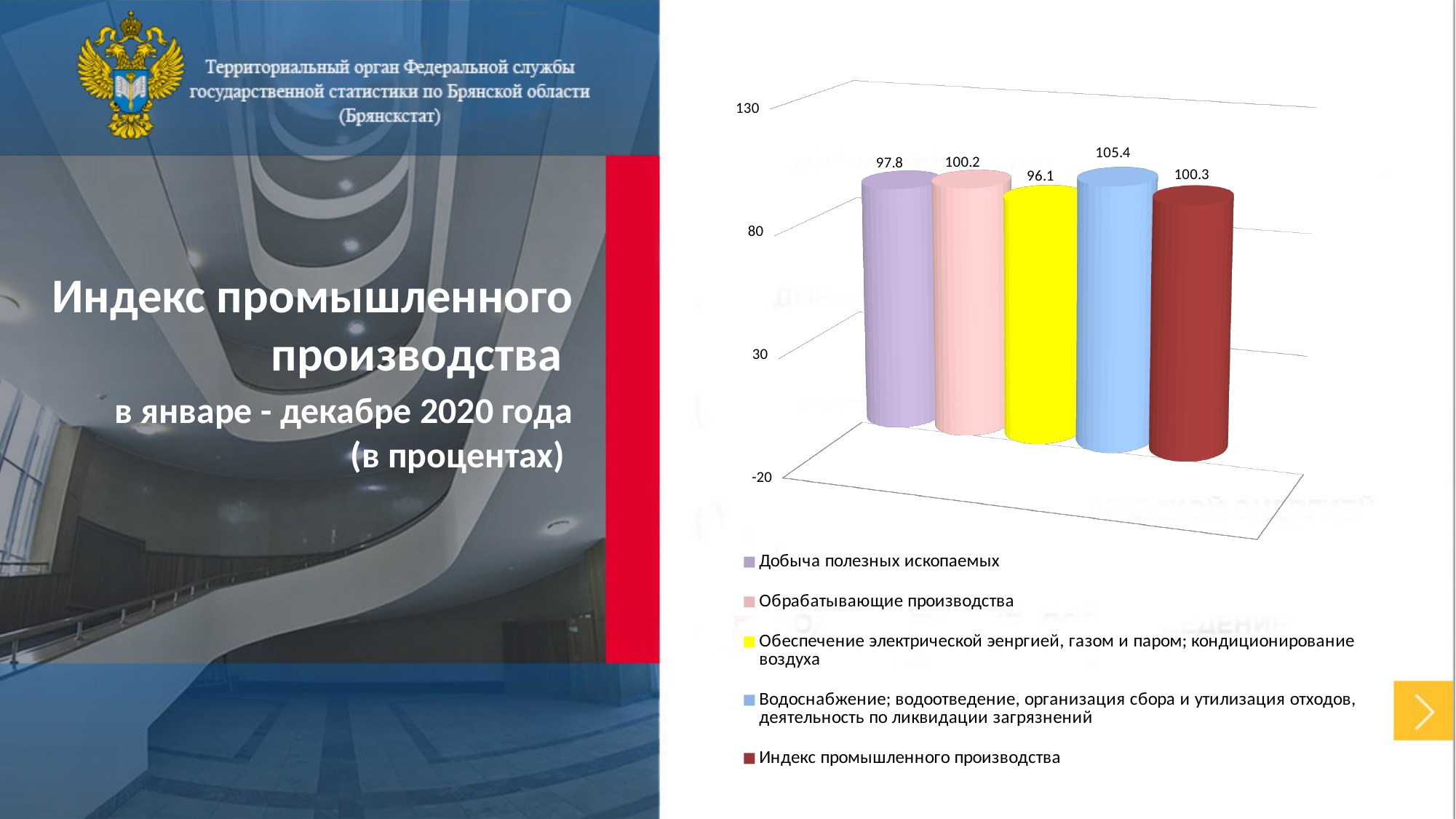
What is the value for Индекс промышленного производства? 100.3 Which category has the lowest value? Обеспечение электрической энергией, газом и паром; кондиционирование воздуха Which is larger: the value for Добыча полезных ископаемых or the value for Обрабатывающие производства? Обрабатывающие производства What is the value for Водоснабжение; водоотведение, организация сбора и утилизация отходов, деятельность по ликвидации загрязнений? 105.4 How many bars are plotted on the chart? 5 How many entries does the legend list? 5 What is the value for Обеспечение электрической энергией, газом и паром; кондиционирование воздуха? 96.1 What is the difference between the values for Водоснабжение; водоотведение and Обеспечение электрической энергией, газом и паром? 9.3 What is the value for Добыча полезных ископаемых? 97.8 What is the value for Обрабатывающие производства? 100.2 Which category has the highest value? Водоснабжение; водоотведение, организация сбора и утилизация отходов, деятельность по ликвидации загрязнений What kind of chart is shown on the slide? Bar chart